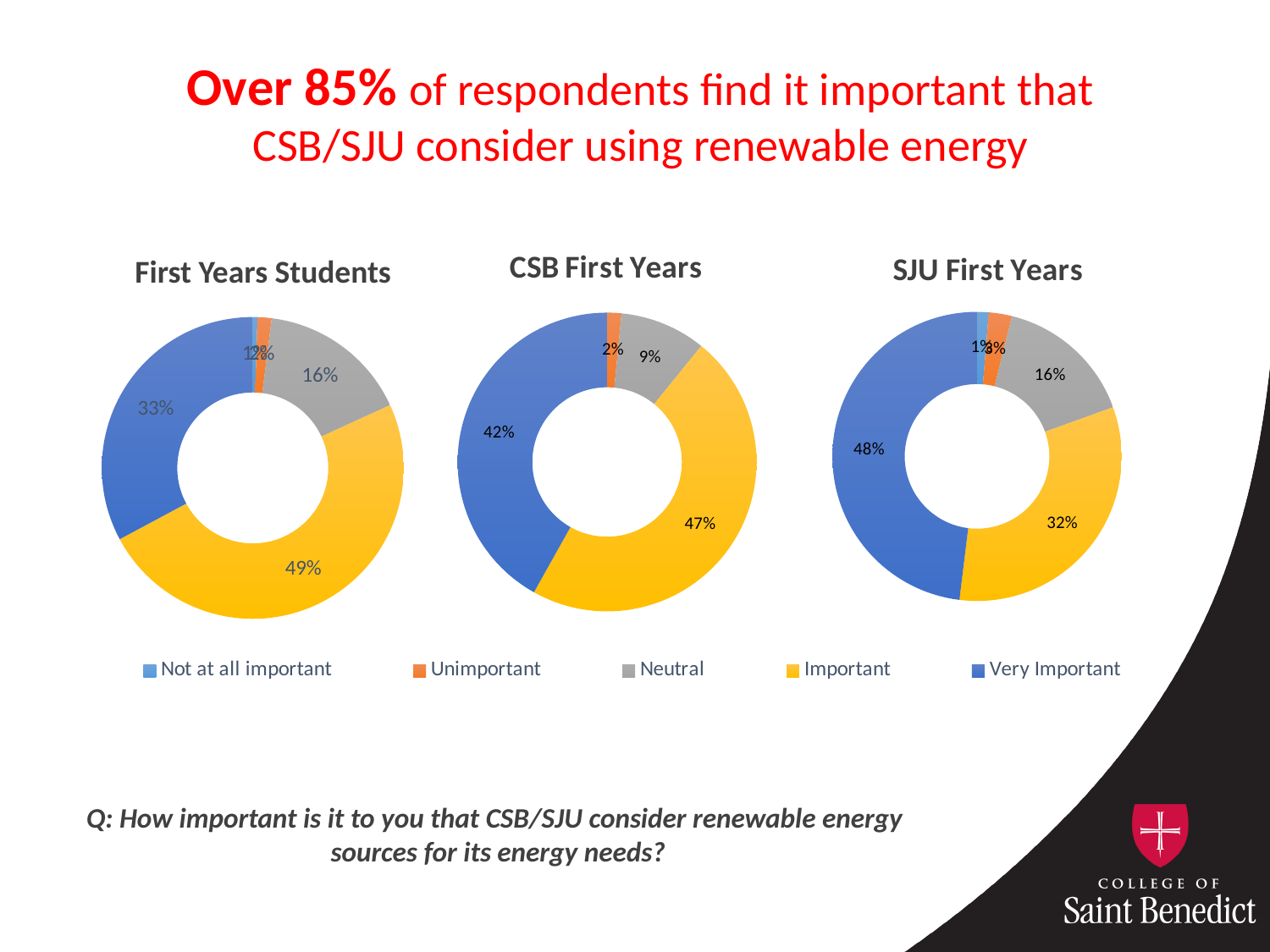
In the 'CSB First Years' chart, what share of respondents answered 'Important'? 47% In the 'First Years Students' chart, what share of respondents answered 'Neutral'? 16% In the 'First Years Students' chart, what share of respondents answered 'Very Important'? 33% In the 'CSB First Years' chart, what is the difference between the 'Important' and 'Very Important' shares? 5% In the 'First Years Students' chart, what share of respondents answered 'Important'? 49% How many series does the legend list for the charts on the slide? 5 In the 'SJU First Years' chart, what share of respondents answered 'Important'? 32% In the 'SJU First Years' chart, what share of respondents answered 'Very Important'? 48% In the 'First Years Students' chart, which response category has the largest share? Important In the 'CSB First Years' chart, what share of respondents answered 'Neutral'? 9% In the 'CSB First Years' chart, what share of respondents answered 'Very Important'? 42% In the 'SJU First Years' chart, which response category has the largest share? Very Important